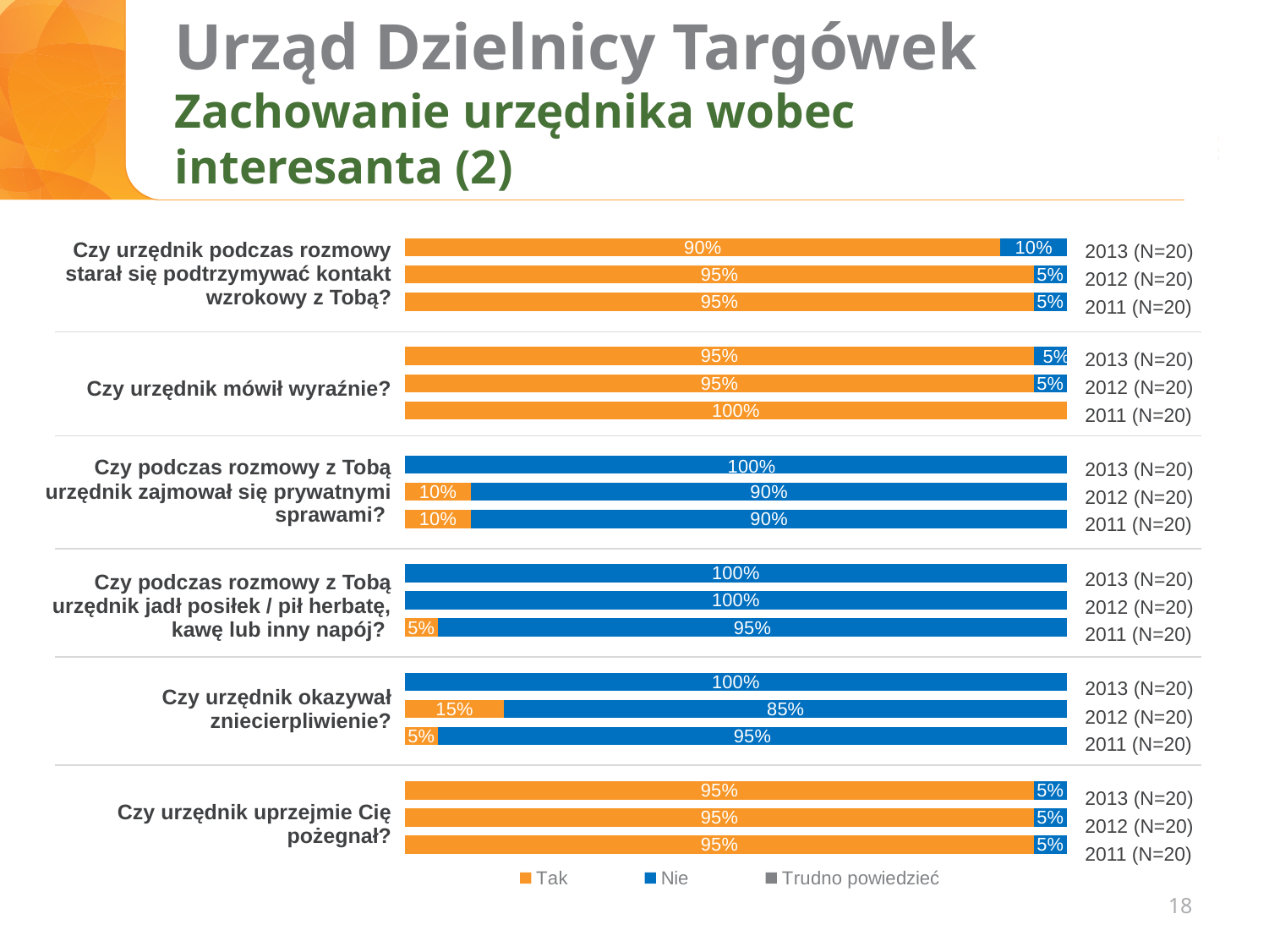
Which colour represents the "Nie" answers in the chart? Blue For "Czy urzędnik podczas rozmowy starał się podtrzymywać kontakt wzrokowy z Tobą?", which year had the lowest "Tak" share? 2013 For "Czy urzędnik okazywał zniecierpliwienie?", what is the difference between the "Tak" share in 2012 and in 2011? 10 percentage points What kind of chart is shown on the slide? Stacked horizontal bar chart For "Czy urzędnik okazywał zniecierpliwienie?", which year had the highest "Tak" share? 2012 How many series does the legend list? 3 What percentage answered "Nie" in 2012 to "Czy urzędnik okazywał zniecierpliwienie?"? 85% For "Czy podczas rozmowy z Tobą urzędnik jadł posiłek / pił herbatę, kawę lub inny napój?", is the "Nie" share larger in 2013 or in 2011? 2013 What percentage answered "Tak" in 2012 to "Czy podczas rozmowy z Tobą urzędnik zajmował się prywatnymi sprawami?"? 10% What percentage answered "Nie" in 2013 to "Czy urzędnik uprzejmie Cię pożegnał?"? 5% What percentage answered "Tak" in 2011 to "Czy urzędnik mówił wyraźnie?"? 100% What percentage answered "Tak" in 2013 to "Czy urzędnik podczas rozmowy starał się podtrzymywać kontakt wzrokowy z Tobą?"? 90%